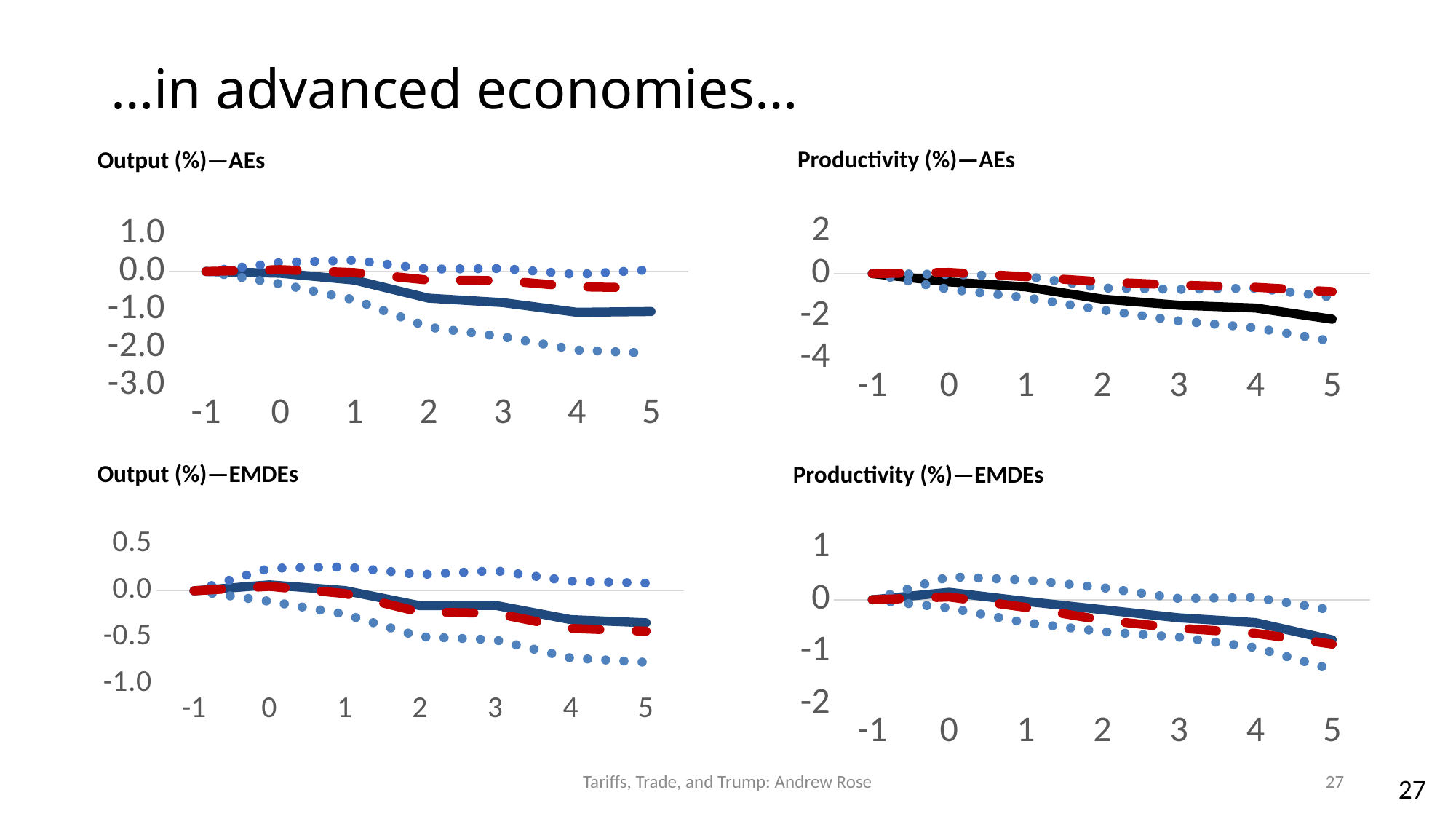
What is the lowest value shown on the y axis of the "Output (%)—AEs" chart? -3.0 In the "Productivity (%)—AEs" chart, does the solid black line rise or fall along the x axis? fall How many charts are shown on the slide? 4 In the "Productivity (%)—EMDEs" chart, is the value of the solid line at x = 5 greater or less than 0? less In the "Productivity (%)—AEs" chart, how many points are on the x axis? 7 What is the title of the chart in the bottom-right of the slide? Productivity (%)—EMDEs In the "Output (%)—EMDEs" chart, is the value of the solid line at x = 5 greater or less than -0.5? greater In the "Productivity (%)—AEs" chart, is the value of the solid line at x = 3 greater or less than -4? greater In the "Output (%)—AEs" chart, which x value has the lowest solid-line value, 0 or 4? 4 In the "Output (%)—EMDEs" chart, does the solid line rise or fall from x = 0 to x = 5? fall What kind of chart is the "Output (%)—AEs" chart? line chart